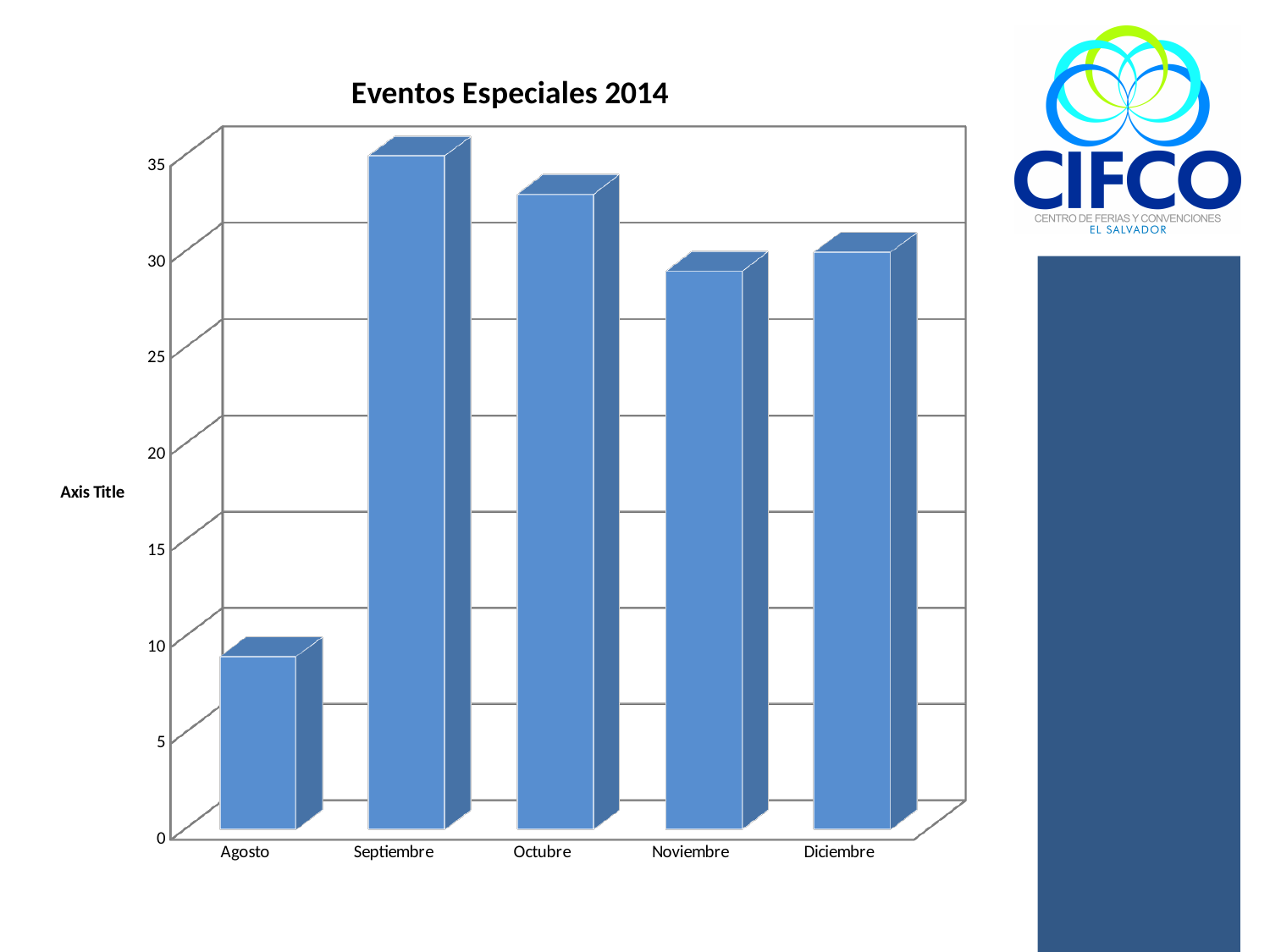
Which is larger, the value for Octubre or the value for Noviembre? Octubre What is the title of the chart? Eventos Especiales 2014 Is the value for Octubre greater or less than 30? greater Does the value rise or fall from Agosto to Septiembre? rise Which month has the highest bar? Septiembre Is the value for Septiembre greater or less than 30? greater Is the value for Agosto greater or less than 10? less Which month has the lowest bar? Agosto What type of chart is shown on the slide? Bar chart How many months (categories) are shown on the x axis? 5